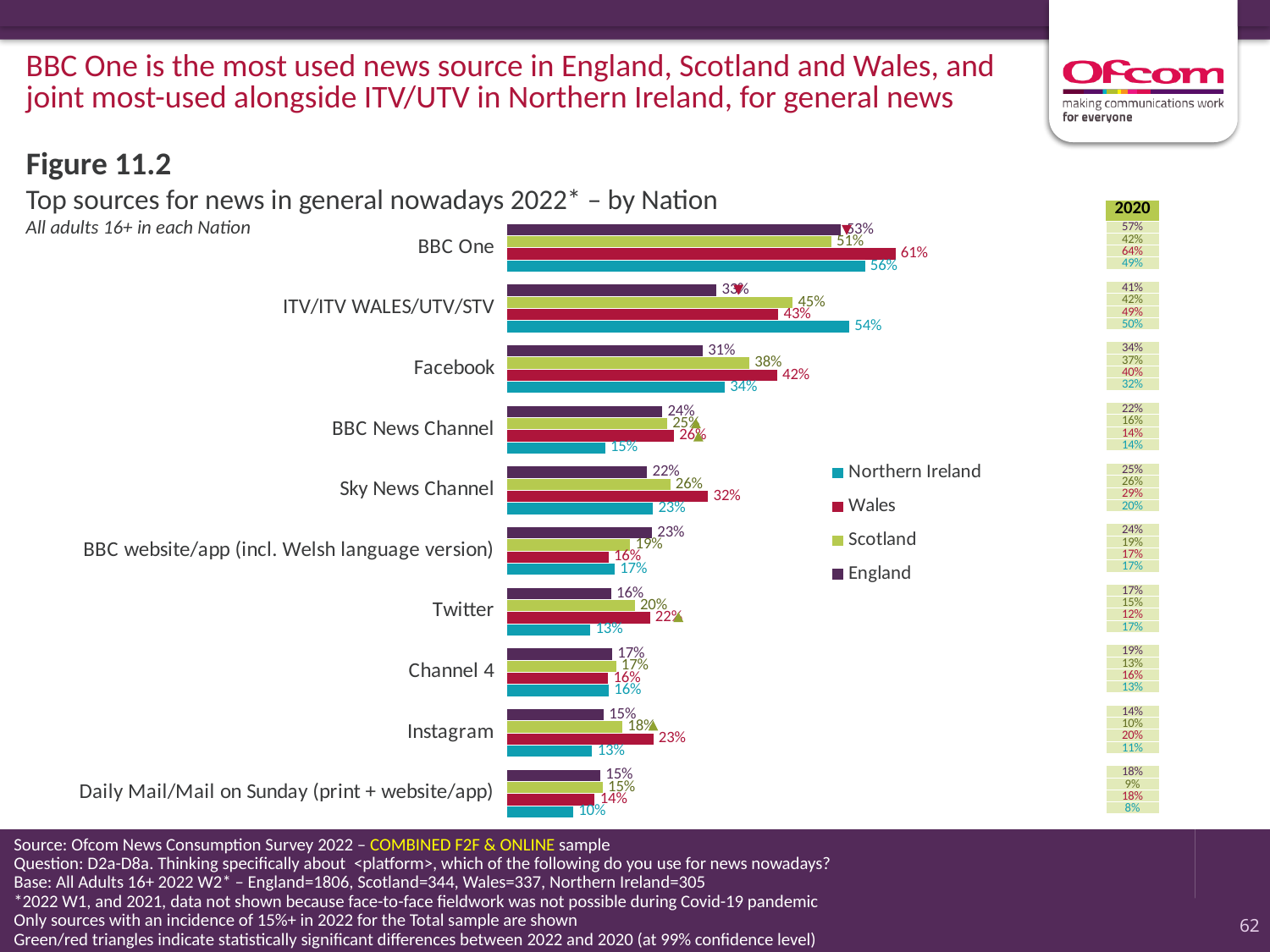
Which nation has the highest value for Sky News Channel? Wales Which nation has the lowest value for BBC News Channel? Northern Ireland What is the value for Northern Ireland for ITV/ITV WALES/UTV/STV? 54% How many nations does the legend list? 4 Which is larger for Twitter: the value for Scotland or the value for Northern Ireland? Scotland What is the Scotland value for Instagram? 18% What type of chart is shown on the slide? Bar chart Which nation is represented by the purple bars? England How many news sources are listed on the chart? 10 What percentage of adults in England use Facebook for news? 31% What percentage of adults in Wales use BBC One for news in general nowadays? 61% What is the difference between the Wales and England values for BBC One? 8%